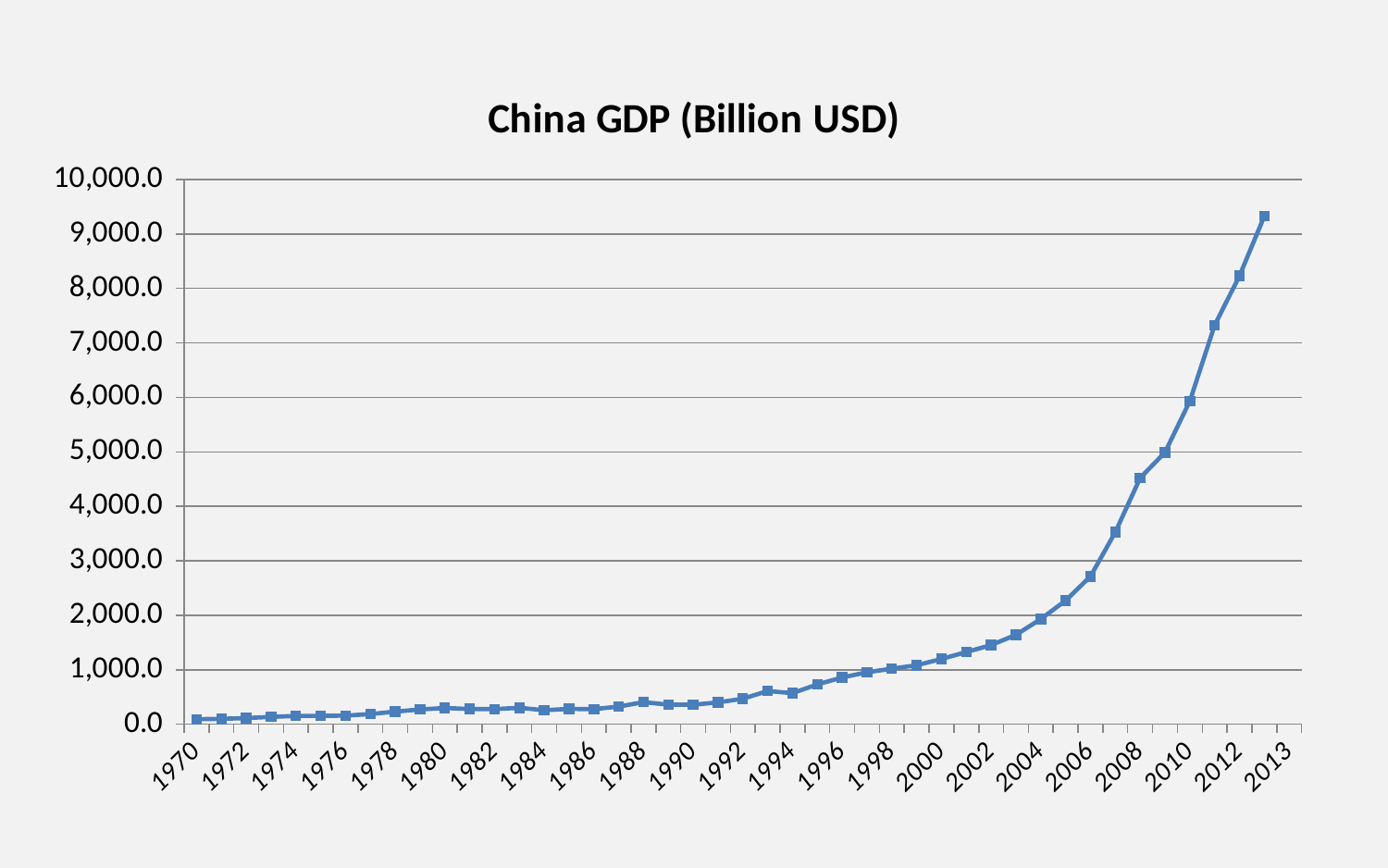
What is the title of the chart? China GDP (Billion USD) Do the GDP values generally rise or fall from 1970 to 2013? rise Is the value for 2011 greater or less than 7,000? greater What is the highest value shown on the vertical axis? 10,000.0 Is the value for 1990 greater or less than 1,000? less What kind of chart is shown on the slide? line chart Is the value for 2006 greater or less than 3,000? less Which year has the highest GDP value on the chart? 2013 Which year has the larger GDP value, 2004 or 2008? 2008 Which year has the lowest GDP value on the chart? 1970